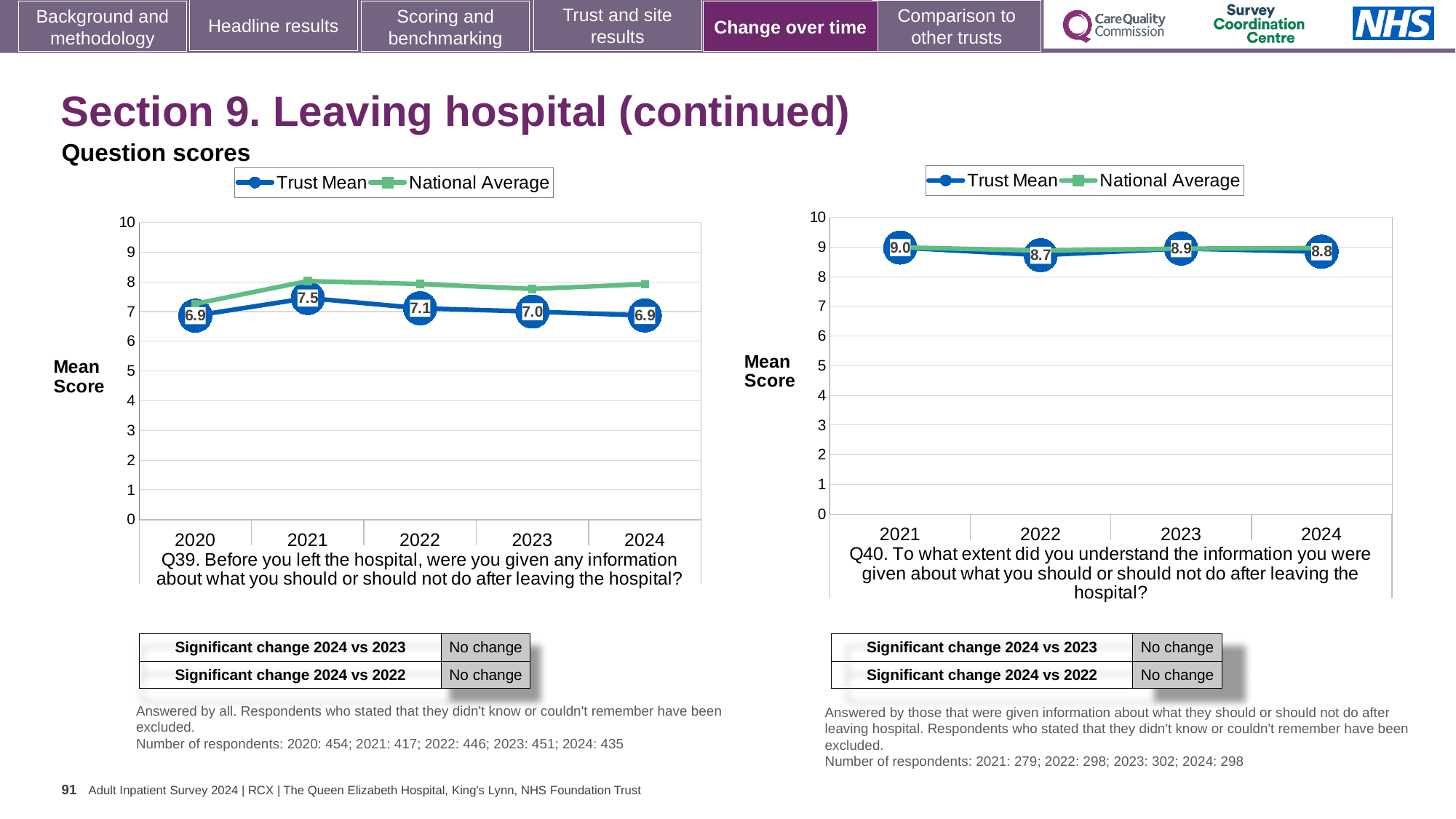
In the Q40 chart on the right, which year has the lowest Trust Mean score? 2022 In the Q39 chart on the left, which year has the highest Trust Mean score? 2021 In the Q40 chart on the right, what is the Trust Mean score for 2022? 8.7 In the Q40 chart on the right, what is the difference between the Trust Mean scores for 2021 and 2022? 0.3 In the Q39 chart on the left, how many years are shown on the x axis? 5 In the Q39 chart on the left, what is the Trust Mean score for 2024? 6.9 What type of chart is the Q39 chart on the left? Line chart In the Q39 chart on the left, what is the Trust Mean score for 2021? 7.5 In the Q39 chart on the left, is the National Average for 2021 greater or less than 7? greater How many series does the legend of the Q40 chart on the right list? 2 In the Q40 chart on the right, which is larger, the Trust Mean for 2021 or for 2024? 2021 In the Q39 chart on the left, what is the difference between the Trust Mean scores for 2021 and 2024? 0.6